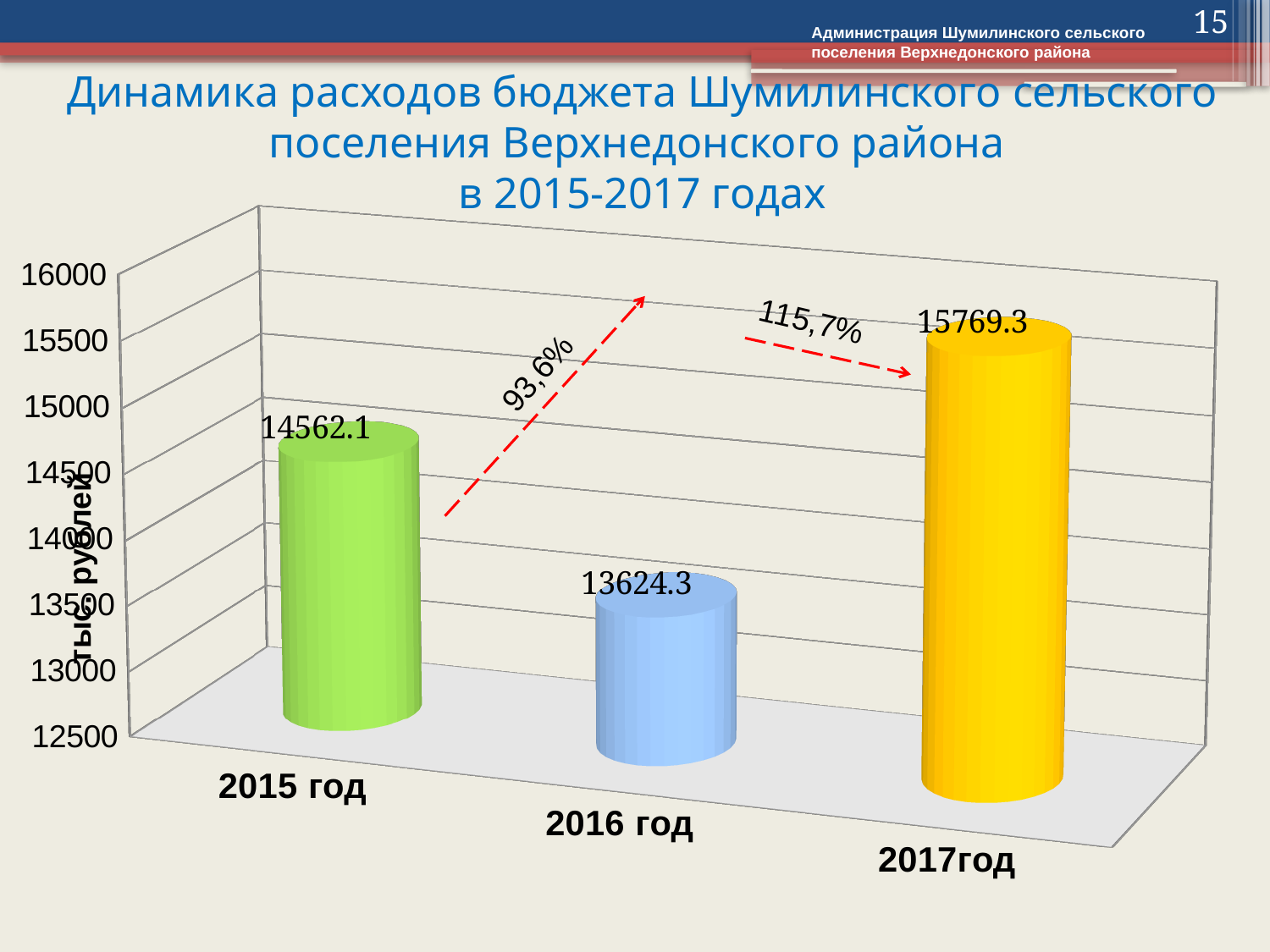
Which year has the lowest value? 2016 год What is the value for 2015 год? 14562.1 What is the difference between the values for 2015 год and 2016 год? 937.8 Which is larger, the value for 2015 год or the value for 2016 год? 2015 год What is the label of the vertical axis? тыс. рублей What is the value for 2017год? 15769.3 How many years are shown on the chart? 3 What is the difference between the values for 2017год and 2015 год? 1207.2 What is the value for 2016 год? 13624.3 Is the value for 2016 год greater or less than 14000? less What kind of chart is shown on the slide? bar chart Which year has the highest value? 2017год